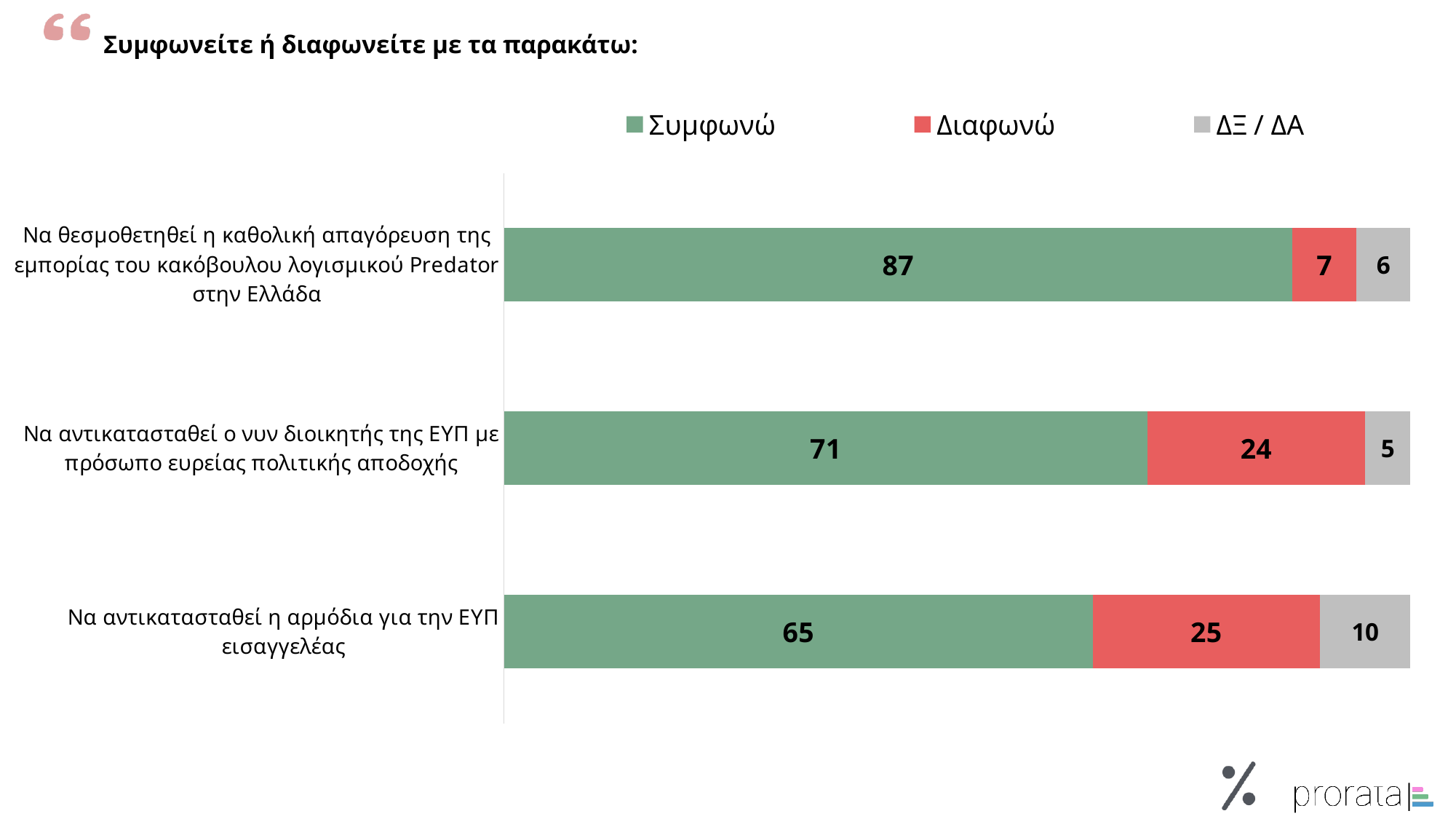
What is the Συμφωνώ value for 'Να θεσμοθετηθεί η καθολική απαγόρευση της εμπορίας του κακόβουλου λογισμικού Predator στην Ελλάδα'? 87 Which statement has the highest Συμφωνώ value? Να θεσμοθετηθεί η καθολική απαγόρευση της εμπορίας του κακόβουλου λογισμικού Predator στην Ελλάδα Which statement has the lowest Διαφωνώ value? Να θεσμοθετηθεί η καθολική απαγόρευση της εμπορίας του κακόβουλου λογισμικού Predator στην Ελλάδα What is the total of the stacked bar for 'Να αντικατασταθεί ο νυν διοικητής της ΕΥΠ με πρόσωπο ευρείας πολιτικής αποδοχής'? 100 What is the ΔΞ / ΔΑ value for 'Να αντικατασταθεί η αρμόδια για την ΕΥΠ εισαγγελέας'? 10 What is the difference between the Συμφωνώ values for the Predator ban statement and the ΕΥΠ prosecutor statement? 22 Which colour represents Διαφωνώ in the legend? Red Which is larger: the ΔΞ / ΔΑ value for the ΕΥΠ prosecutor statement or for the ΕΥΠ director statement? ΕΥΠ prosecutor statement (Να αντικατασταθεί η αρμόδια για την ΕΥΠ εισαγγελέας) How many statements (categories) are shown in the chart? 3 How many series does the legend list? 3 What is the Διαφωνώ value for 'Να αντικατασταθεί ο νυν διοικητής της ΕΥΠ με πρόσωπο ευρείας πολιτικής αποδοχής'? 24 What kind of chart is shown on the slide? Stacked horizontal bar chart